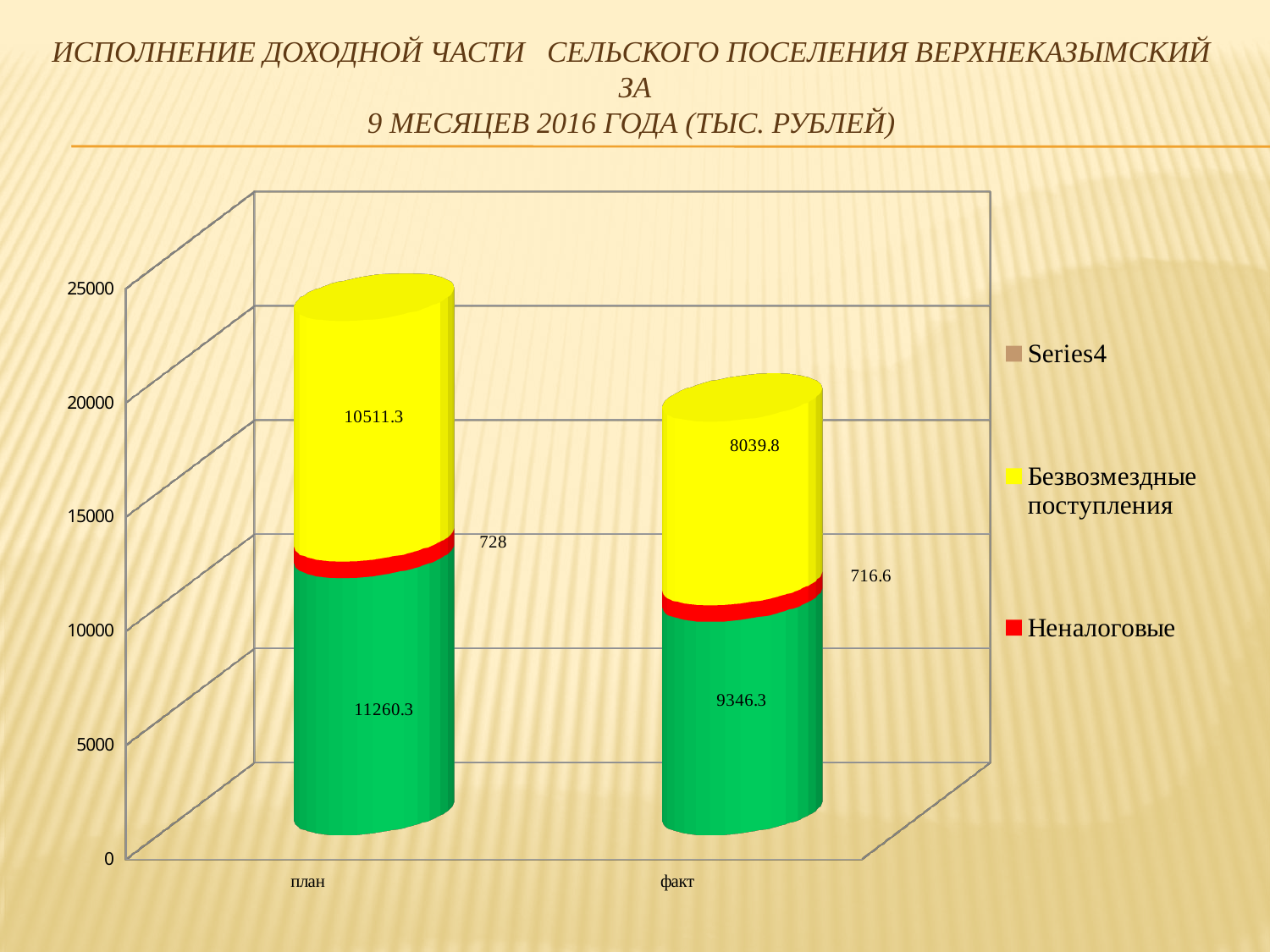
What is the value of Неналоговые for факт? 716.6 What is the value of Безвозмездные поступления for факт? 8039.8 How many categories are shown on the x axis? 2 What is the total of the stacked bar for план? 22499.6 What is the value of Безвозмездные поступления for план? 10511.3 What is the value of the bottom green segment of the факт bar? 9346.3 What is the value of Неналоговые for план? 728 Which is larger, Неналоговые for план or for факт? план What is the total of the stacked bar for факт? 18102.7 What kind of chart is shown on the slide? stacked bar chart Is the total height of the факт bar greater or less than 20000? less What is the difference between Безвозмездные поступления for план and for факт? 2471.5